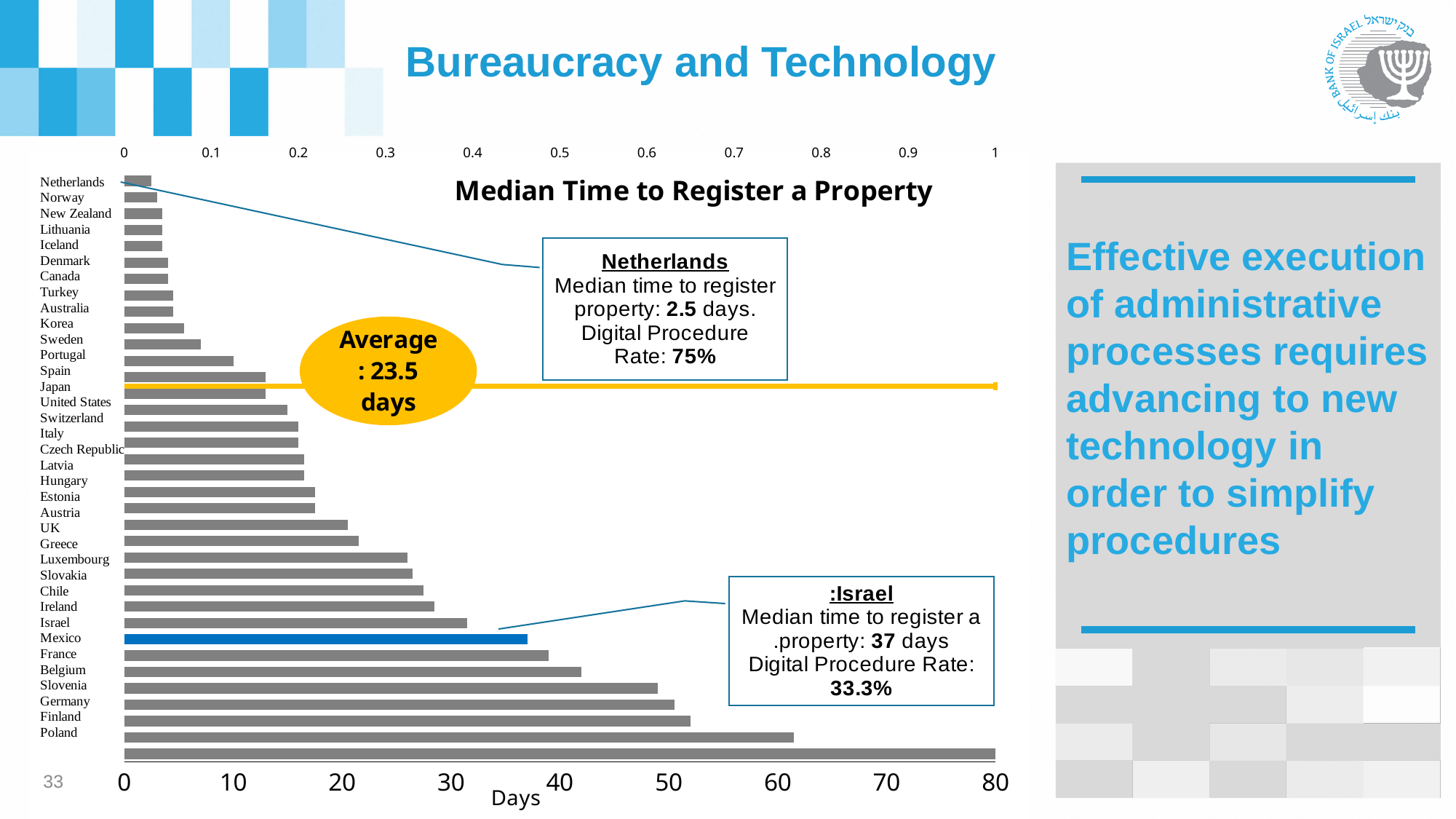
What is the average median time to register a property shown on the chart? 23.5 days How many days longer is the median time to register a property in Israel than in the Netherlands? 34.5 days Which has a longer median time to register a property, Israel or the Netherlands? Israel Is the value for Israel greater or less than 30 days? greater What is the median time to register a property in the Netherlands? 2.5 days Is Israel's median time to register a property greater or less than the average of 23.5 days? greater What kind of chart is shown on the slide? bar chart What is the median time to register a property in Israel? 37 days What is the Digital Procedure Rate given for Israel in the callout box? 33.3% What is the title of the chart? Median Time to Register a Property Which country has the shortest median time to register a property? Netherlands Is the longest bar on the chart greater or less than 70 days? greater